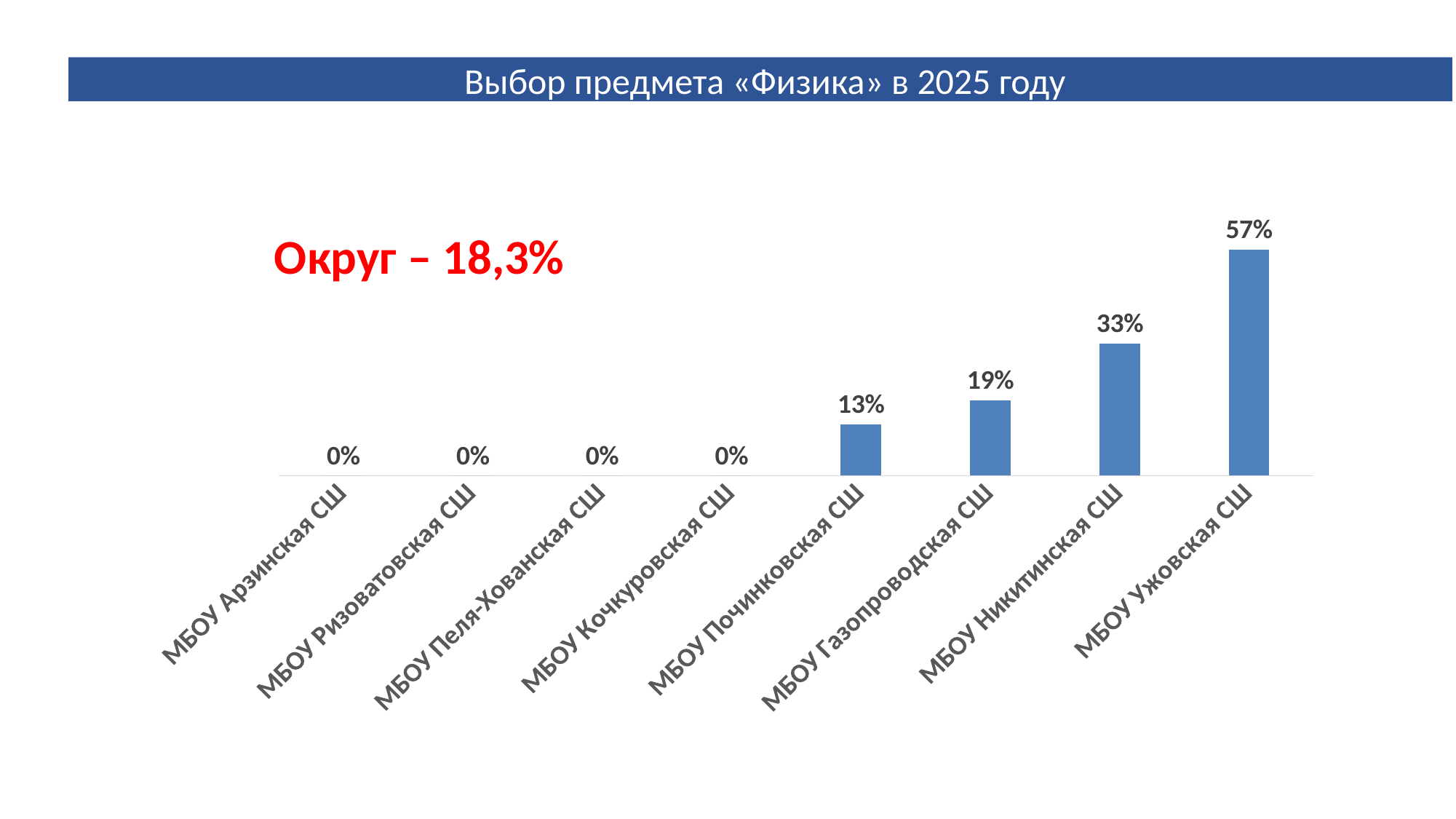
What is the value for МБОУ Ужовская СШ? 57% What is the value for МБОУ Газопроводская СШ? 19% What kind of chart is shown on the slide? Bar chart What is the difference between the values for МБОУ Ужовская СШ and МБОУ Никитинская СШ? 24% Which is larger, the value for МБОУ Никитинская СШ or МБОУ Газопроводская СШ? МБОУ Никитинская СШ What is the value for МБОУ Арзинская СШ? 0% What is the difference between the values for МБОУ Газопроводская СШ and МБОУ Починковская СШ? 6% How many schools have a value of 0%? 4 How many schools are shown on the chart? 8 What is the value for МБОУ Починковская СШ? 13% Which school has the highest value? МБОУ Ужовская СШ What is the value for МБОУ Никитинская СШ? 33%